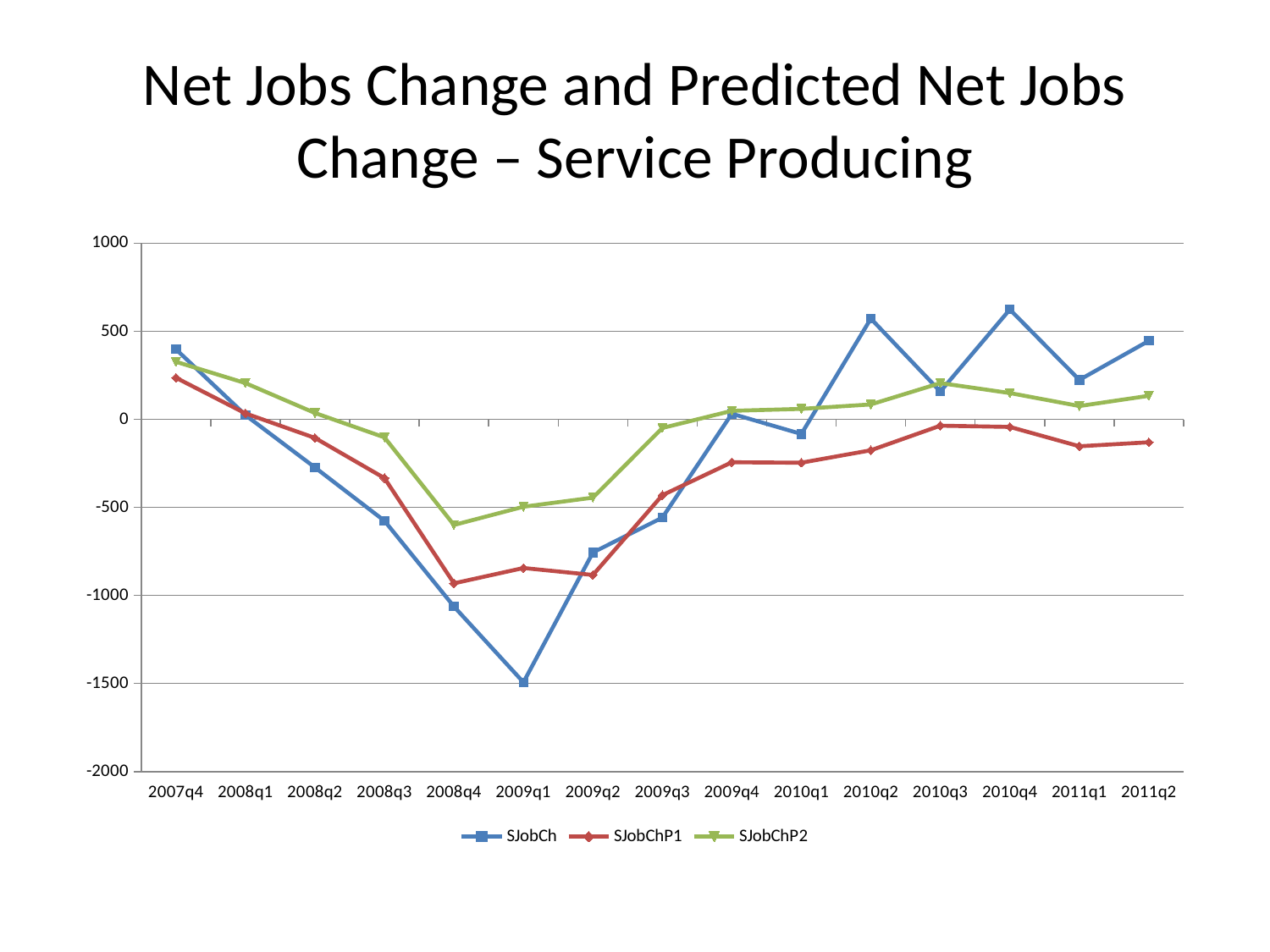
Do the SJobCh values rise or fall from 2007q4 to 2009q1? fall Is the value of SJobChP2 in 2008q4 greater or less than -500? less In 2009q1, which series has the larger value, SJobCh or SJobChP2? SJobChP2 Is the value of SJobCh in 2010q2 greater or less than 500? greater Is the value of SJobCh in 2009q1 greater or less than -1000? less In which quarter does the SJobCh series reach its lowest value? 2009q1 What is the title of the chart? Net Jobs Change and Predicted Net Jobs Change – Service Producing How many quarters are plotted along the x axis? 15 In which quarter does the SJobChP2 series reach its highest value? 2007q4 What kind of chart is shown on the slide? line chart In which quarter does the SJobChP1 series reach its lowest value? 2008q4 How many series does the legend list? 3